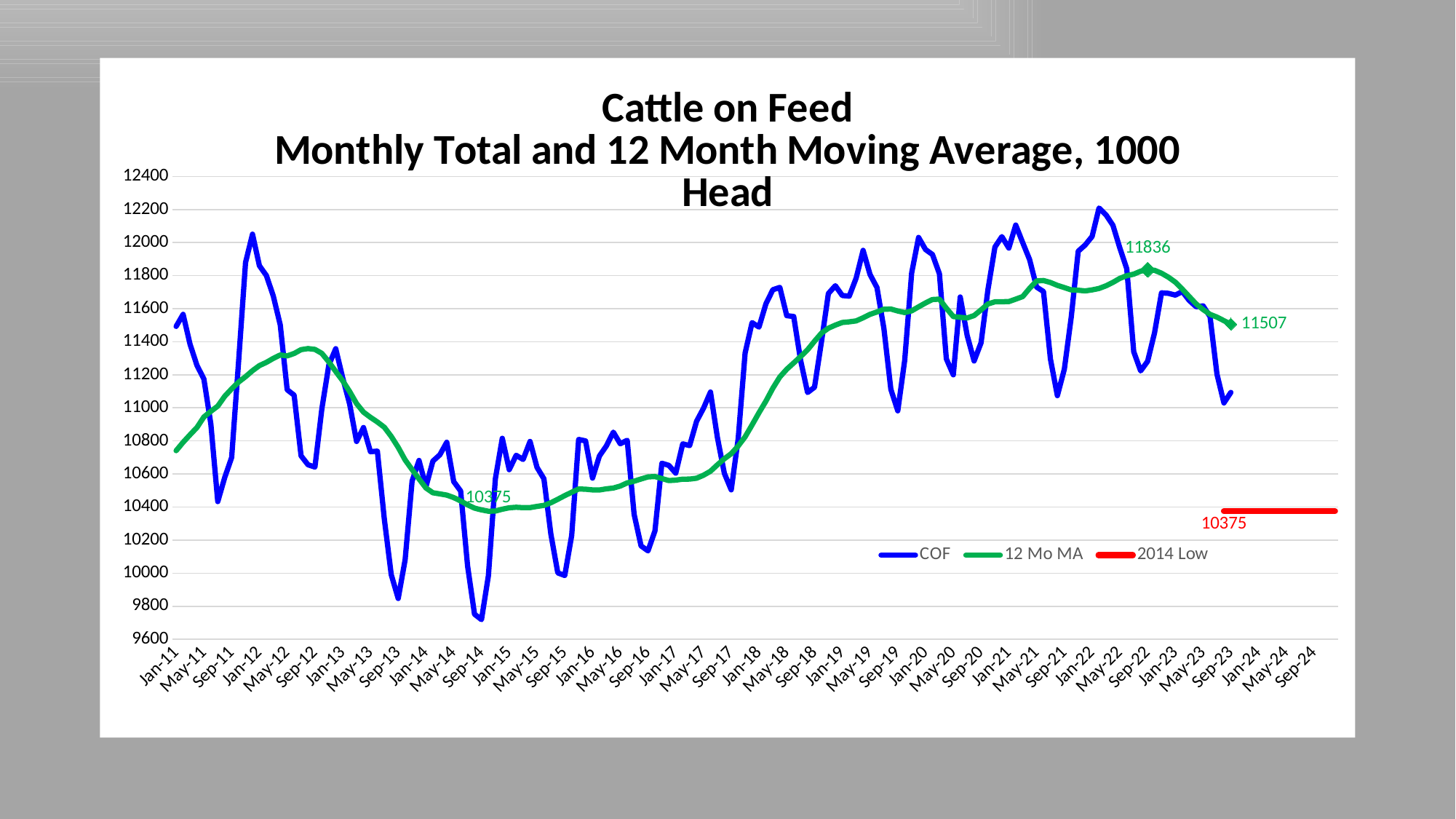
How many series does the legend list? 3 Does the 12 Mo MA series rise or fall between Sep-22 and Sep-23? fall What is the difference between the 12 Mo MA labelled values 11836 and 11507? 329 What is the highest labelled value of the 12 Mo MA series? 11836 How much higher is the 12 Mo MA peak of 11836 than the 2014 Low of 10375? 1461 What are the three series named in the legend? COF, 12 Mo MA, 2014 Low What is the labelled value of the 12 Mo MA series at the end of the line (Sep-23)? 11507 Is the highest COF value (around early 2022) greater or less than 12000? greater What kind of chart is shown on the slide? line chart Is the lowest COF value (around Sep-14) greater or less than 10000? less What is the lowest labelled value of the 12 Mo MA series? 10375 What value is labelled for the 2014 Low series? 10375